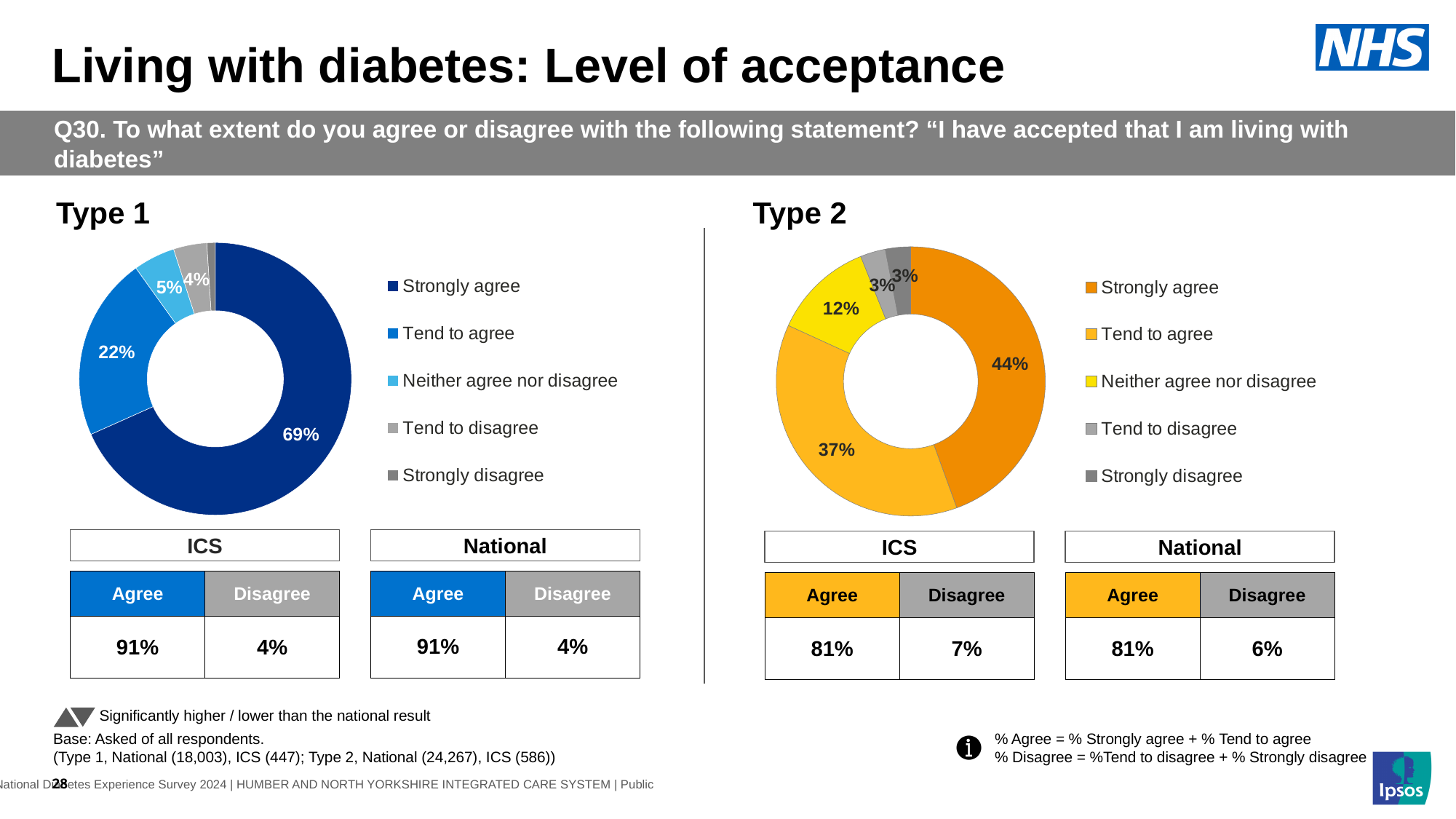
In the Type 1 chart, what percentage of respondents tend to agree? 22% In the Type 2 chart, what percentage of respondents tend to disagree? 3% What kind of chart is used for Type 1? Donut (pie) chart How many response categories does the legend of the Type 2 chart list? 5 Which chart has the larger Strongly agree share, Type 1 or Type 2? Type 1 In the Type 1 chart, what is the difference between the Strongly agree and Tend to agree shares? 47% In the Type 1 chart, what percentage of respondents strongly agree? 69% In the Type 2 chart, which response category has the largest share? Strongly agree In the Type 2 chart, what percentage of respondents neither agree nor disagree? 12% In the Type 1 chart, which response category has the largest share? Strongly agree In the Type 2 chart, what is the difference between the Strongly agree and Tend to agree shares? 7% In the Type 2 chart, what percentage of respondents strongly agree? 44%